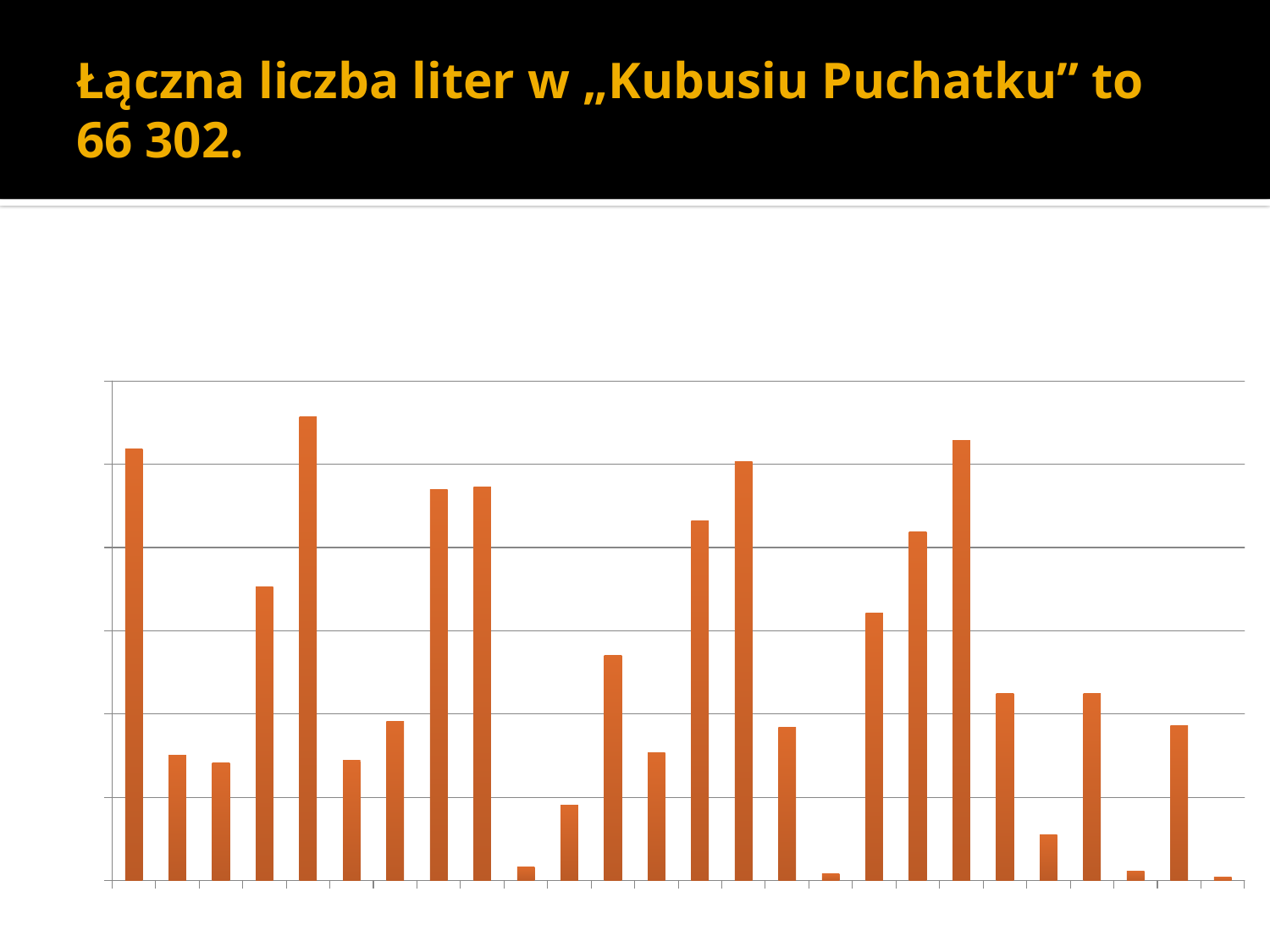
Which is taller, the twelfth bar from the left or the thirteenth bar from the left? the twelfth bar What is the title text shown at the top of the slide? Łączna liczba liter w „Kubusiu Puchatku” to 66 302. Which is taller, the first bar from the left or the fifth bar from the left? the fifth bar Which is taller, the ninth bar from the left or the eleventh bar from the left? the ninth bar How many bars does the chart contain? 26 What kind of chart is shown on the slide? bar chart What colour are the bars in the chart? orange Which bar is the tallest in the chart? the fifth bar from the left